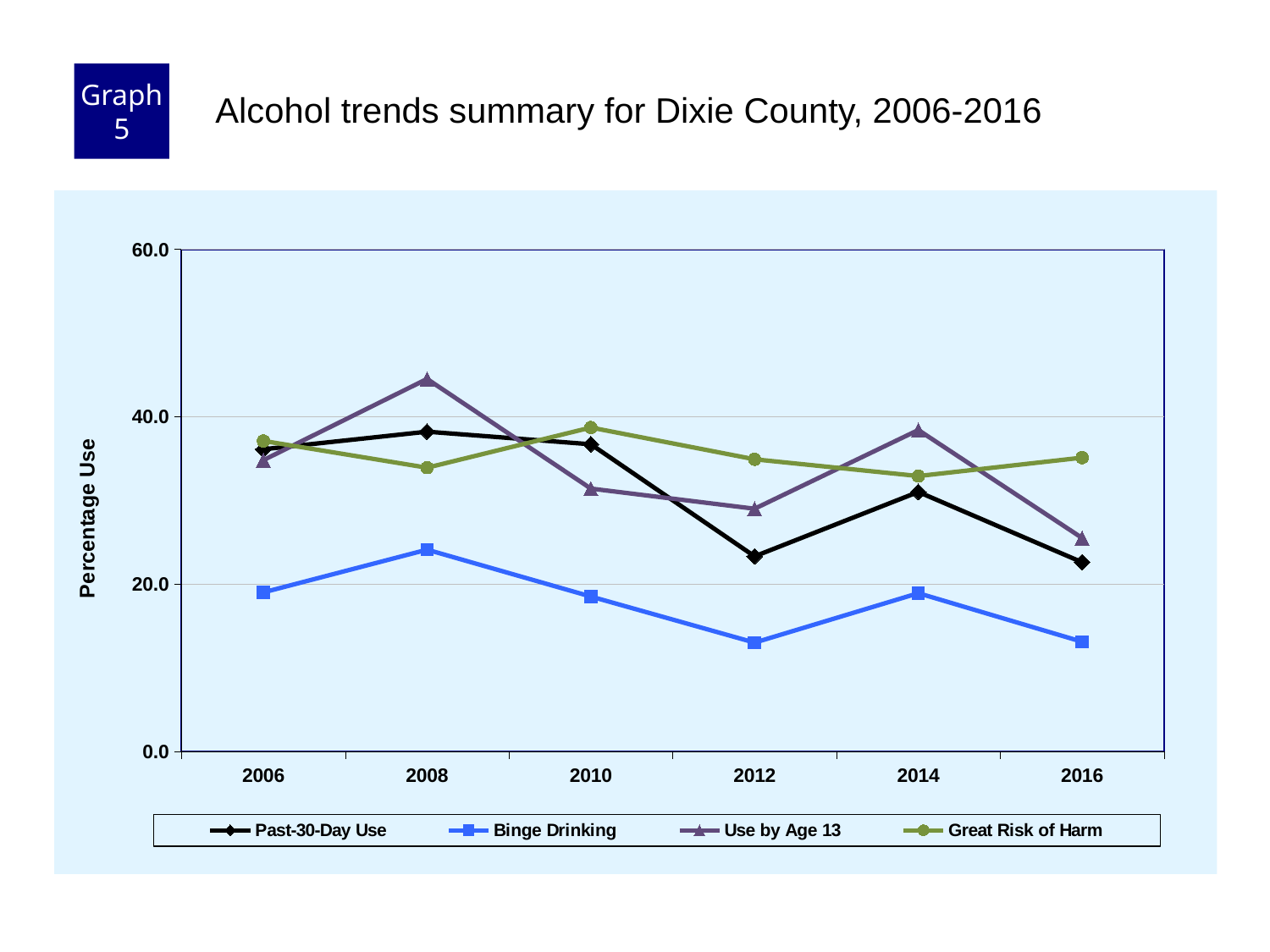
Is the value for Use by Age 13 in 2008 greater or less than 40.0? greater Which series has the highest value in 2014? Use by Age 13 What type of chart is shown on the slide? Line chart How many years are plotted along the x axis? 6 How many series does the legend list? 4 In 2012, which is larger: Past-30-Day Use or Great Risk of Harm? Great Risk of Harm Is the value for Binge Drinking in 2012 greater or less than 20.0? less In which year is Use by Age 13 at its highest? 2008 Does Binge Drinking rise or fall from 2008 to 2012? Fall In which year is Binge Drinking at its highest? 2008 Is the value for Past-30-Day Use in 2012 greater or less than 20.0? greater What is the label on the y axis? Percentage Use